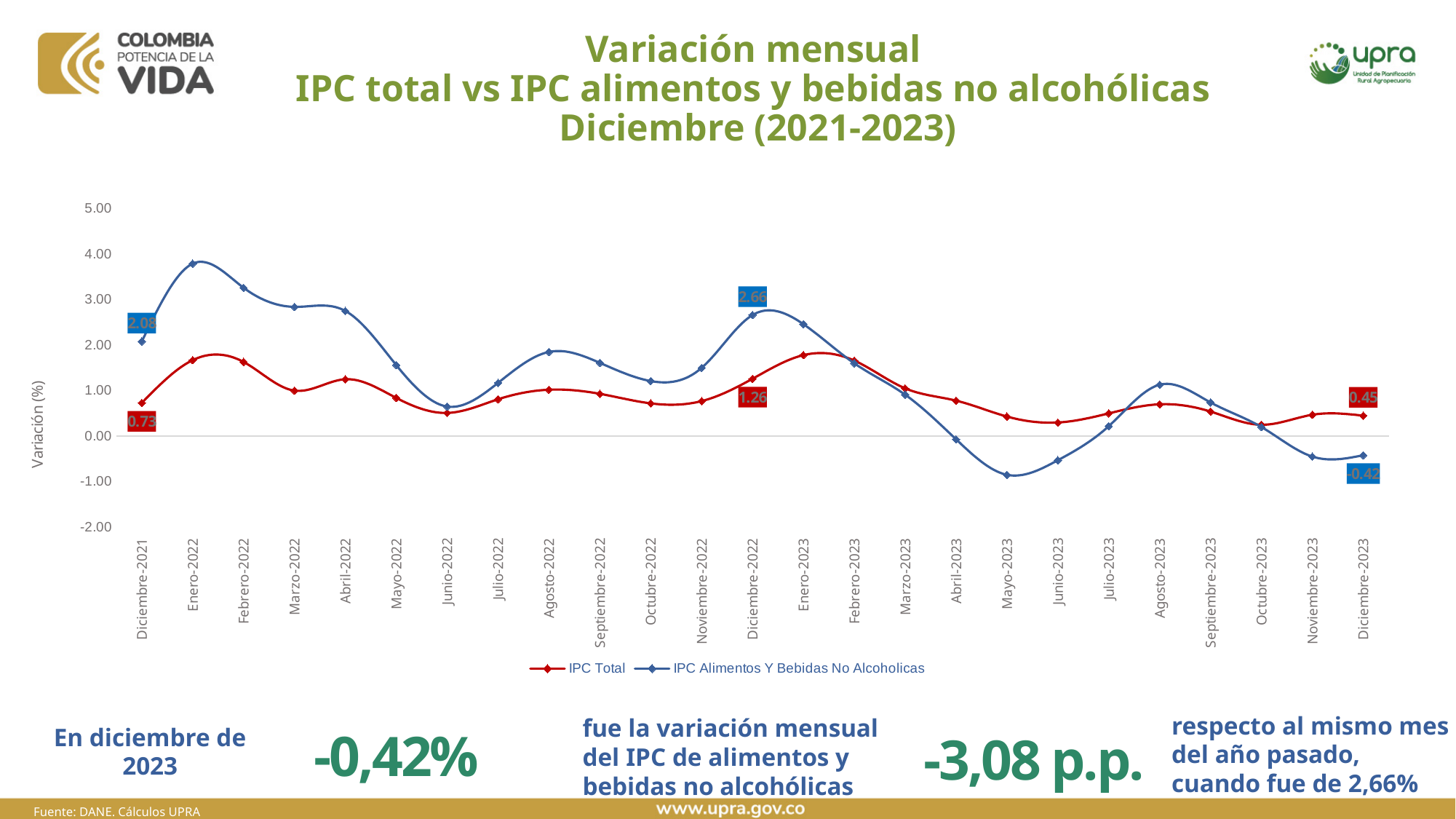
In Diciembre-2022, how much higher is IPC Alimentos Y Bebidas No Alcoholicas than IPC Total? 1.40 What kind of chart is shown on the slide? Line chart In Diciembre-2023, which series has the larger value, IPC Total or IPC Alimentos Y Bebidas No Alcoholicas? IPC Total Is the value of IPC Alimentos Y Bebidas No Alcoholicas for Enero-2022 greater or less than 3.00? greater What is the value of IPC Total for Diciembre-2021? 0.73 What is the value of IPC Total for Diciembre-2023? 0.45 In which month does IPC Alimentos Y Bebidas No Alcoholicas reach its lowest value? Mayo-2023 In Diciembre-2021, what is the difference between IPC Alimentos Y Bebidas No Alcoholicas and IPC Total? 1.35 How many series does the legend list? 2 What is the value of IPC Alimentos Y Bebidas No Alcoholicas for Diciembre-2023? -0.42 In which month does IPC Alimentos Y Bebidas No Alcoholicas reach its highest value? Enero-2022 What is the value of IPC Alimentos Y Bebidas No Alcoholicas for Diciembre-2022? 2.66